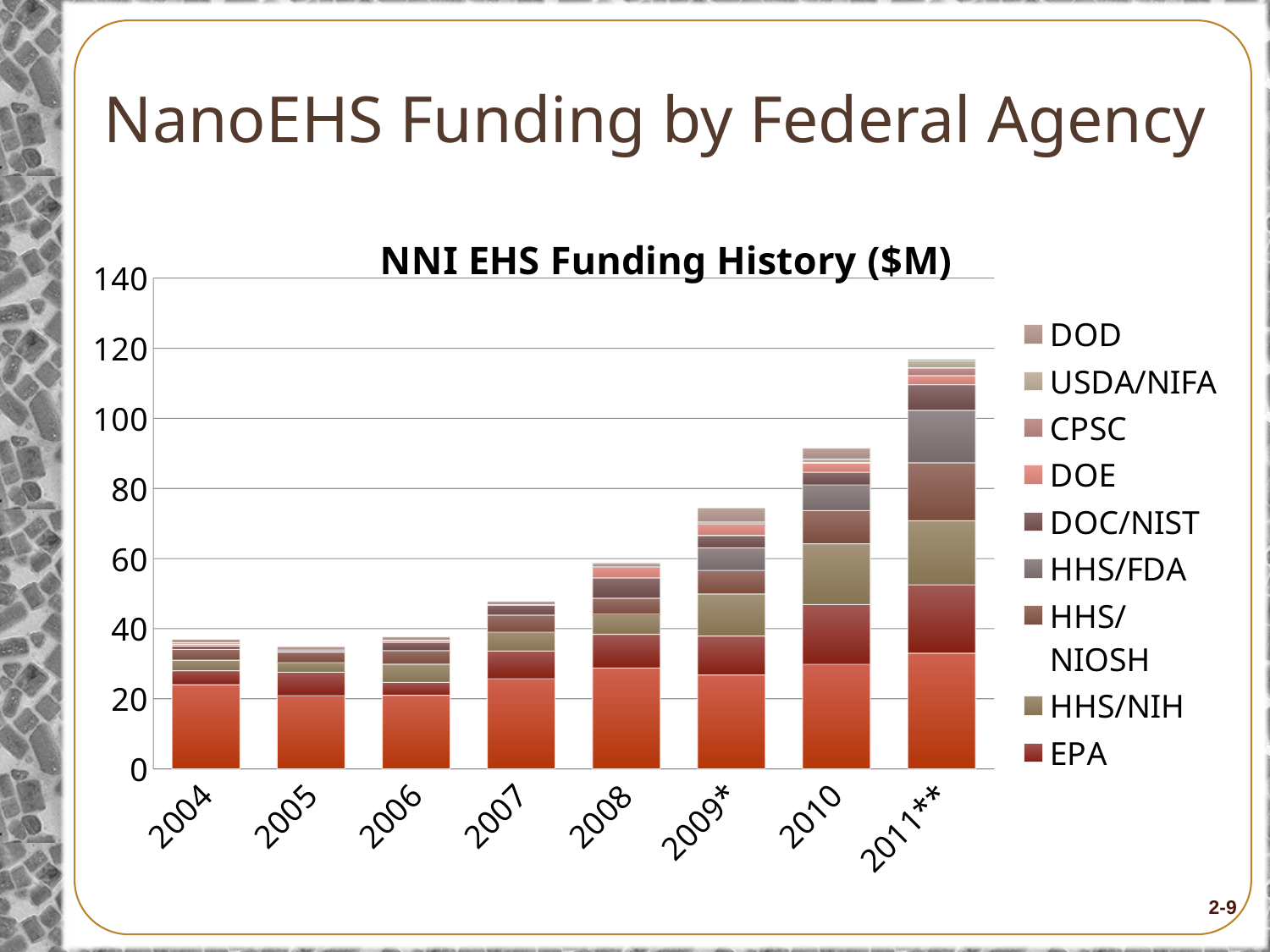
How many years (categories) are shown on the x axis? 8 Which year has the larger total funding, 2010 or 2009*? 2010 Is the total funding for 2011** greater or less than 100? greater Which agency is listed at the bottom of the legend? EPA What is the title of the chart? NNI EHS Funding History ($M) Does total funding generally rise or fall from 2004 to 2011**? Rise Is the total funding for 2004 greater or less than 40? less Is the total funding for 2010 greater or less than 80? greater Which year has the highest total funding? 2011** How many agencies does the legend list? 9 What kind of chart is shown on the slide? Stacked bar chart